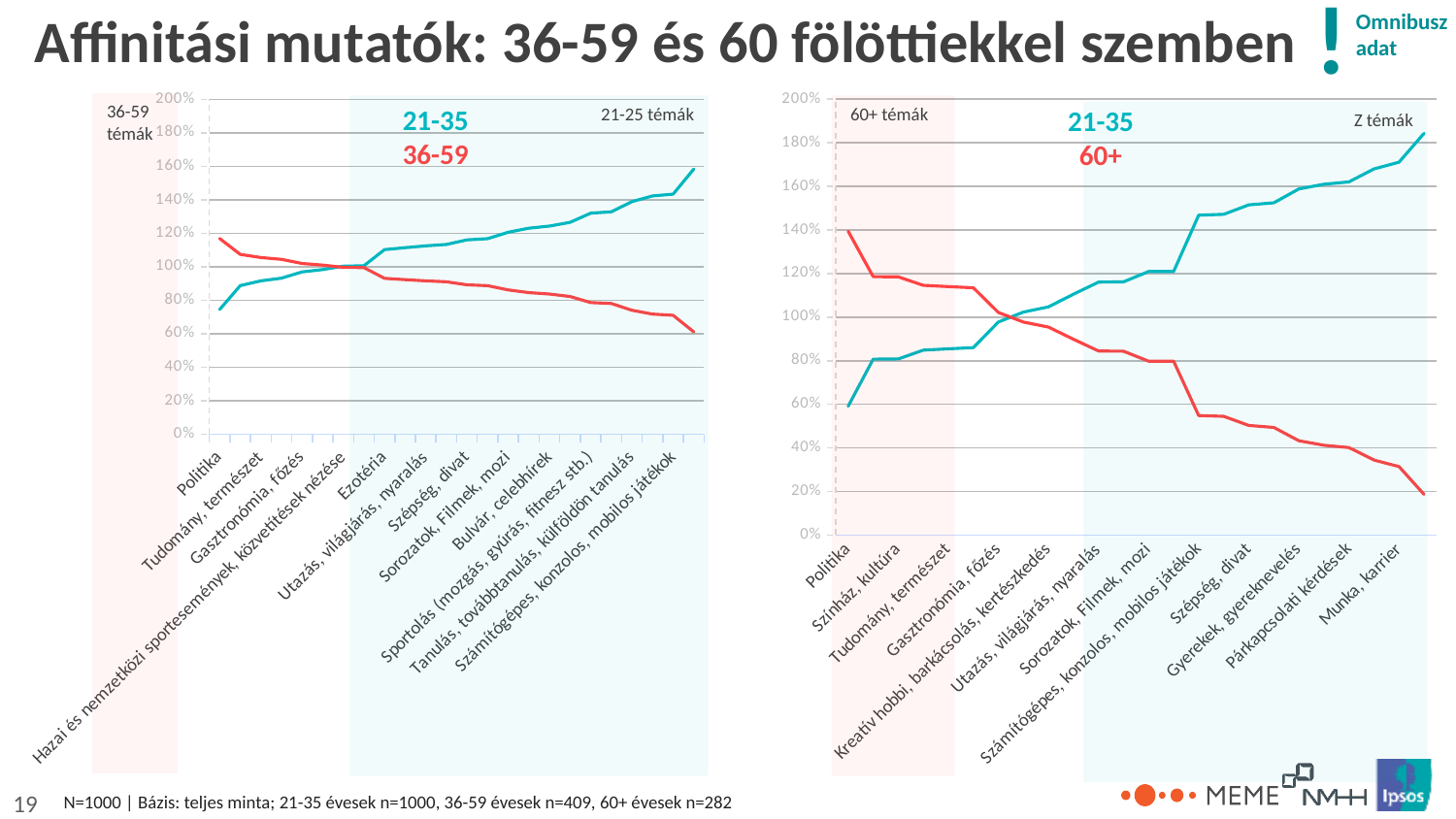
In the right chart (60+ témák), does the 60+ series rise or fall along the x axis? fall In the left chart (36-59 témák), does the 21-35 series rise or fall along the x axis? rise In the left chart (36-59 témák), is the 21-35 value for Számítógépes, konzolos, mobilos játékok greater or less than 140%? greater In the left chart (36-59 témák), is the 21-35 value for Politika greater or less than 100%? less How many categories are shown on the x axis of the left chart (36-59 témák)? 24 In the right chart (60+ témák), which category has the highest 60+ value? Politika What kind of chart is the left chart (36-59 témák)? line chart In the right chart (60+ témák), is the 60+ value for Munka, karrier greater or less than 40%? less In the left chart (36-59 témák), which series has the larger value for Politika, 21-35 or 36-59? 36-59 How many categories are shown on the x axis of the right chart (60+ témák)? 24 How many series does the legend of the right chart (60+ témák) list? 2